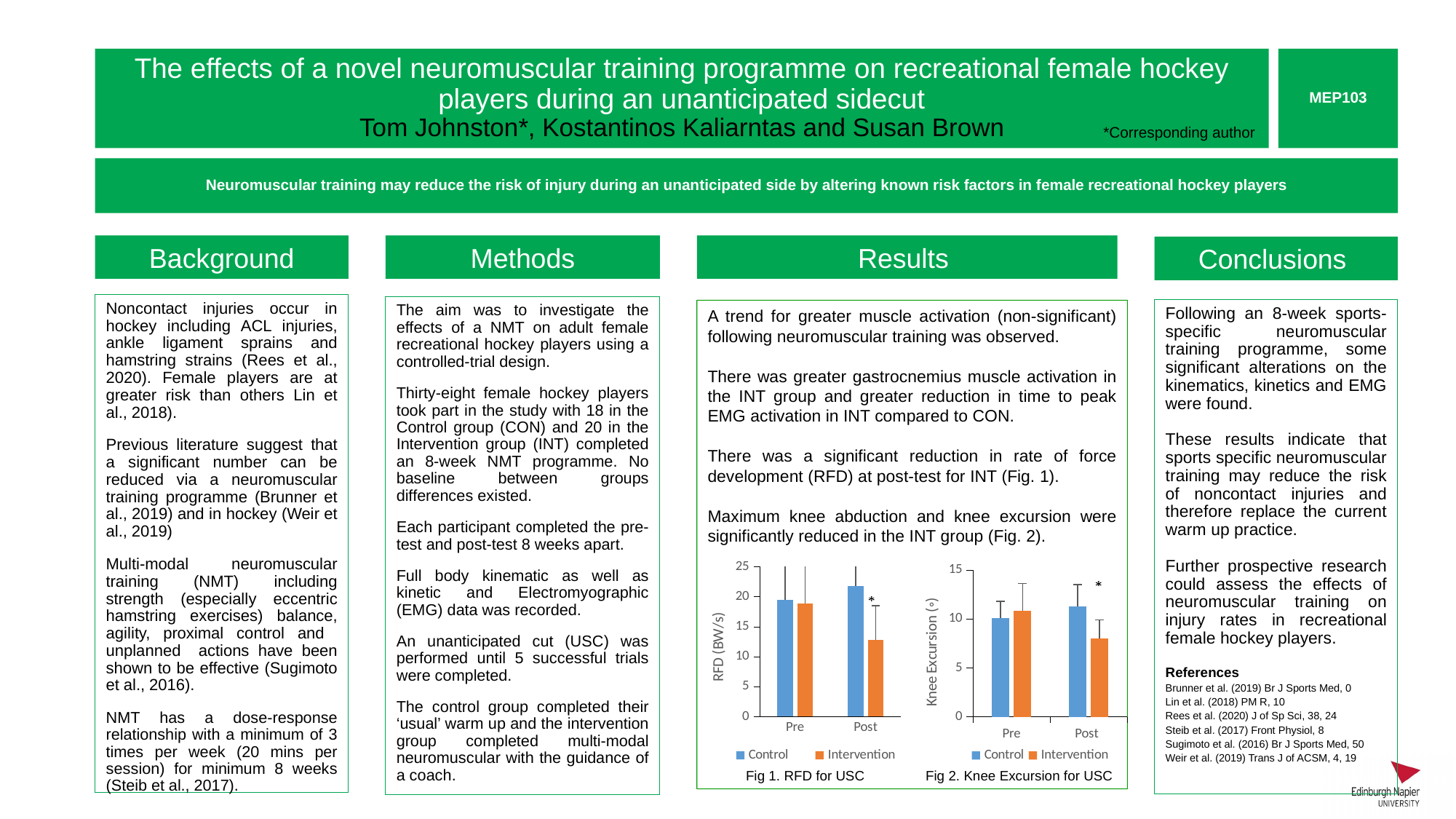
In Fig 1. RFD for USC, is the Intervention value at Post greater or less than 15? less How many series does the legend of Fig 2. Knee Excursion for USC list? 2 In Fig 2. Knee Excursion for USC, which series has the larger value at Post, Control or Intervention? Control What kind of chart is Fig 1. RFD for USC? bar chart In Fig 2. Knee Excursion for USC, is the Intervention value at Post greater or less than 10? less What is the y-axis label of Fig 1. RFD for USC? RFD (BW/s) In Fig 1. RFD for USC, which series has the larger value at Post, Control or Intervention? Control In Fig 1. RFD for USC, is the Control value at Post greater or less than 20? greater In Fig 1. RFD for USC, which bar is the lowest? Intervention at Post In Fig 2. Knee Excursion for USC, which colour represents the Intervention series? orange How many categories are shown on the x axis of Fig 1. RFD for USC? 2